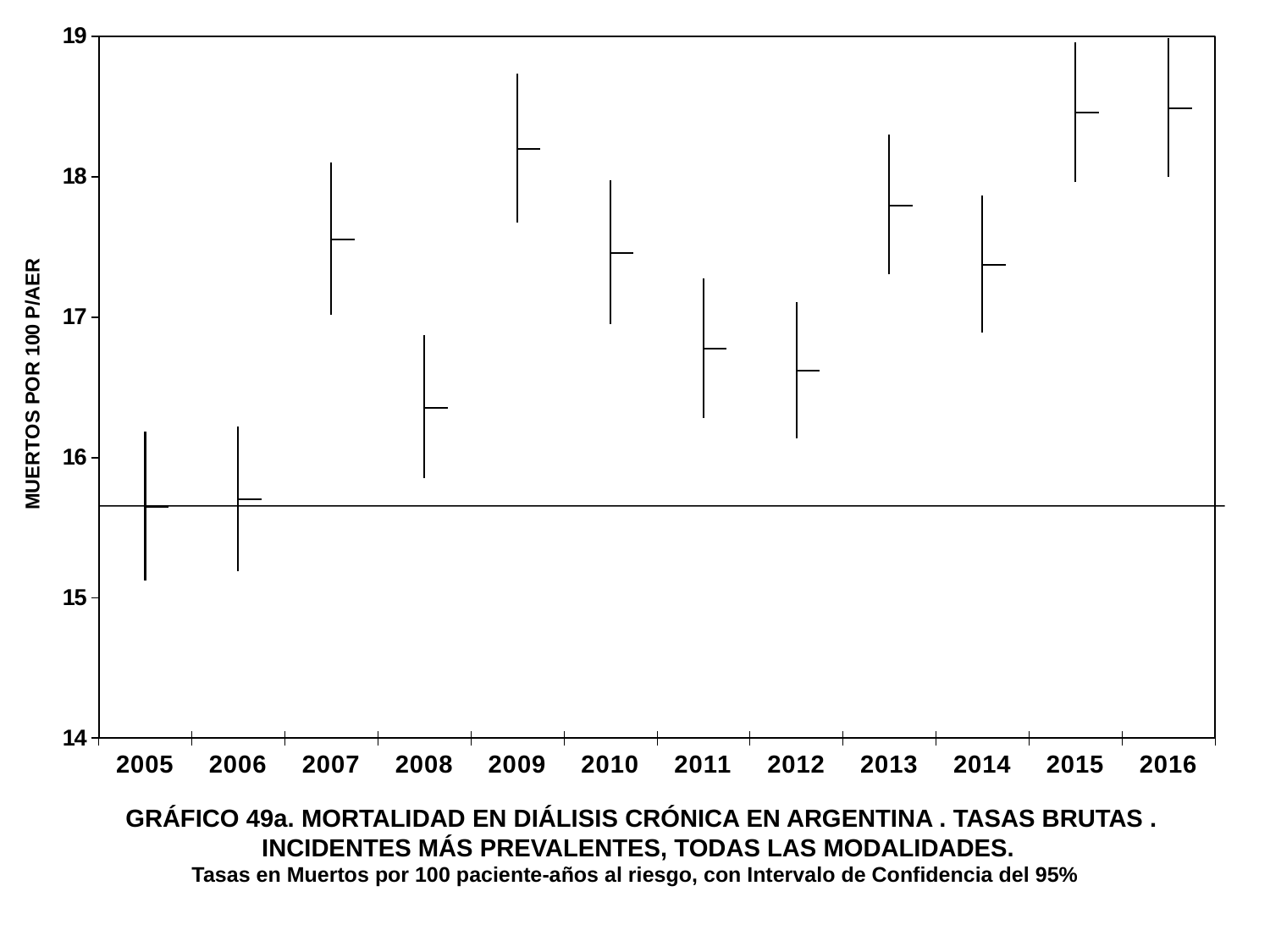
Which year has the higher mortality rate, 2013 or 2014? 2013 Which year has the higher mortality rate, 2007 or 2008? 2007 Overall, do the mortality rates rise or fall from 2005 to 2016? rise Is the value for 2012 greater or less than 17? less Is the value for 2008 greater or less than 16? greater Which year has the higher mortality rate, 2009 or 2010? 2009 Is the value for 2009 greater or less than 18? greater What is the label of the y axis? MUERTOS POR 100 P/AER How many years are shown on the x axis of the chart? 12